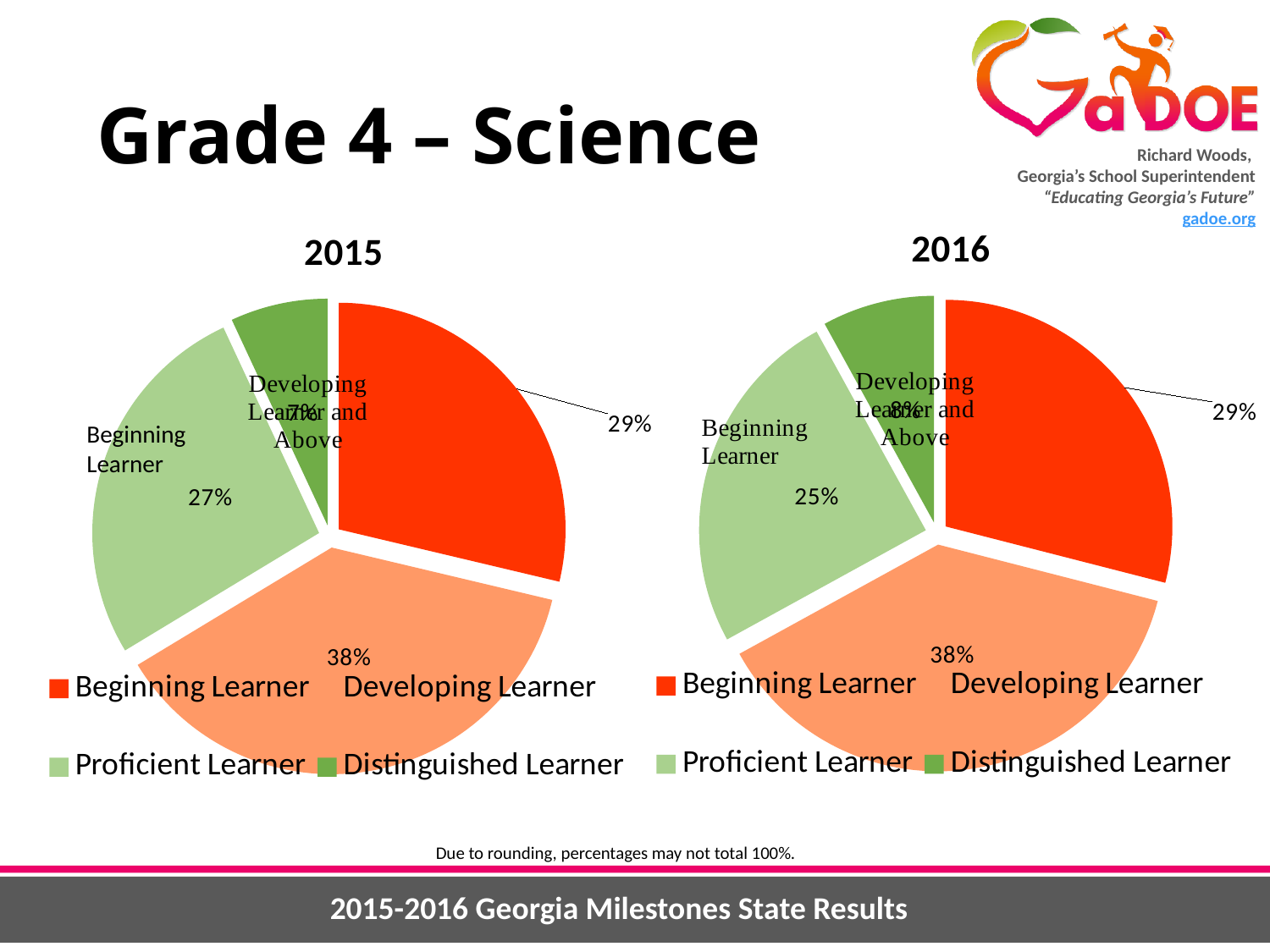
How many categories does the legend of the 2016 pie chart list? 4 In the 2015 pie chart, what percentage of students were Beginning Learners? 29% In the 2016 pie chart, what percentage of students were Proficient Learners? 25% In the 2015 pie chart, what percentage of students were Developing Learners? 38% In the 2015 pie chart, what colour is the Beginning Learner slice? red In the 2015 pie chart, what is the difference between the Developing Learner share and the Proficient Learner share? 11% In the 2016 pie chart, what percentage of students were Developing Learners? 38% How much did the Proficient Learner share change from the 2015 pie chart to the 2016 pie chart? 2% In the 2016 pie chart, which category has the smallest share? Distinguished Learner What kind of chart is used for the 2015 results? pie chart In the 2016 pie chart, which is larger: the Beginning Learner share or the Proficient Learner share? Beginning Learner In the 2015 pie chart, which category has the largest share? Developing Learner